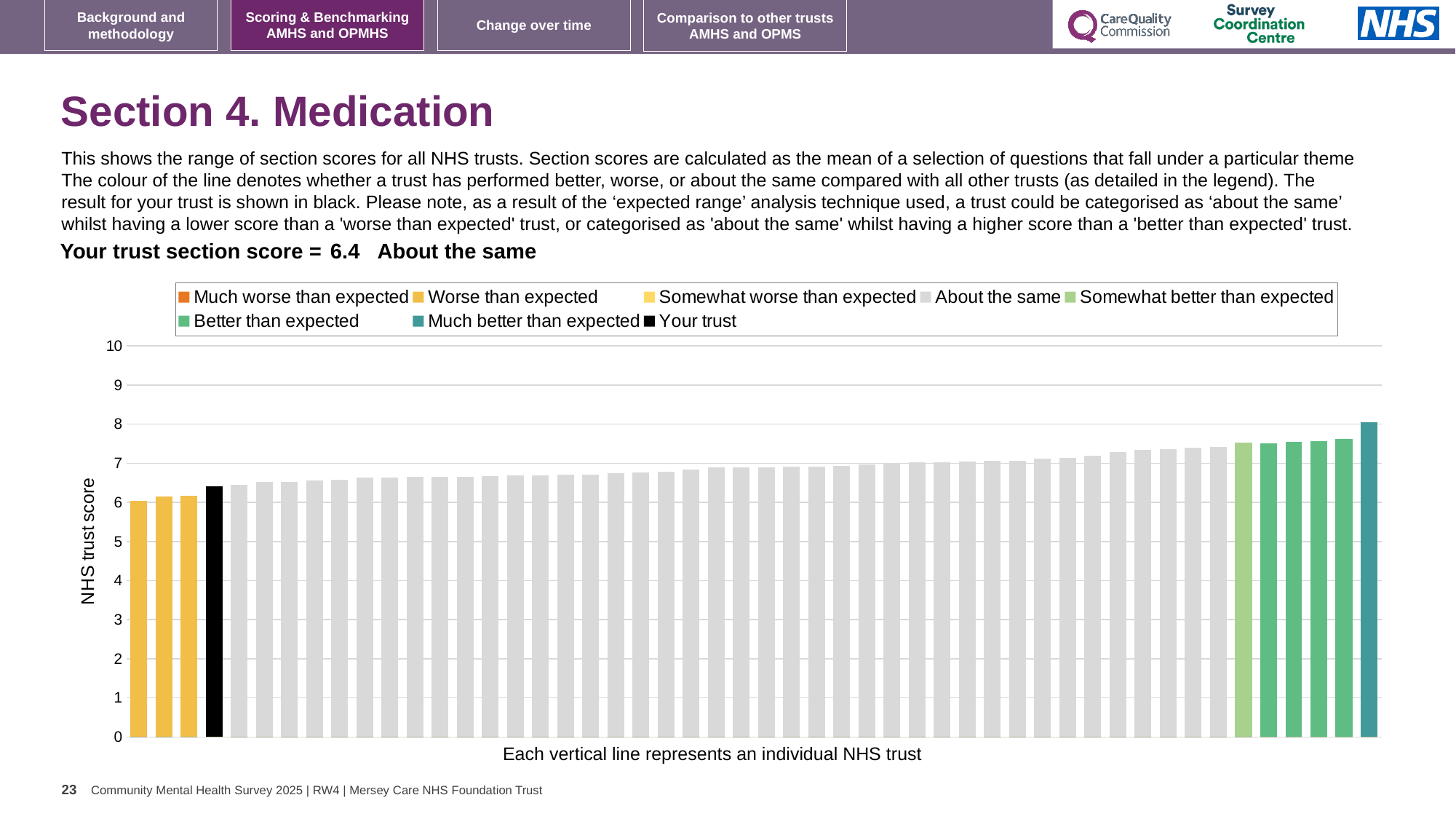
How many entries does the chart legend list? 8 What kind of chart is shown on the slide? bar chart Which legend category does the tallest bar belong to? Much better than expected Which legend category does the black bar represent? Your trust Which is taller: the black 'Your trust' bar or the leftmost bar? the black 'Your trust' bar What is the section score for your trust shown on the slide? 6.4 Is the value of the black 'Your trust' bar greater or less than 5? greater Is the value of the tallest bar greater or less than 7? greater Which legend category does the shortest bar belong to? Worse than expected Do the bar values rise or fall from left to right along the x axis? rise What is the label on the vertical axis of the chart? NHS trust score Is the value of the leftmost bar greater or less than 7? less